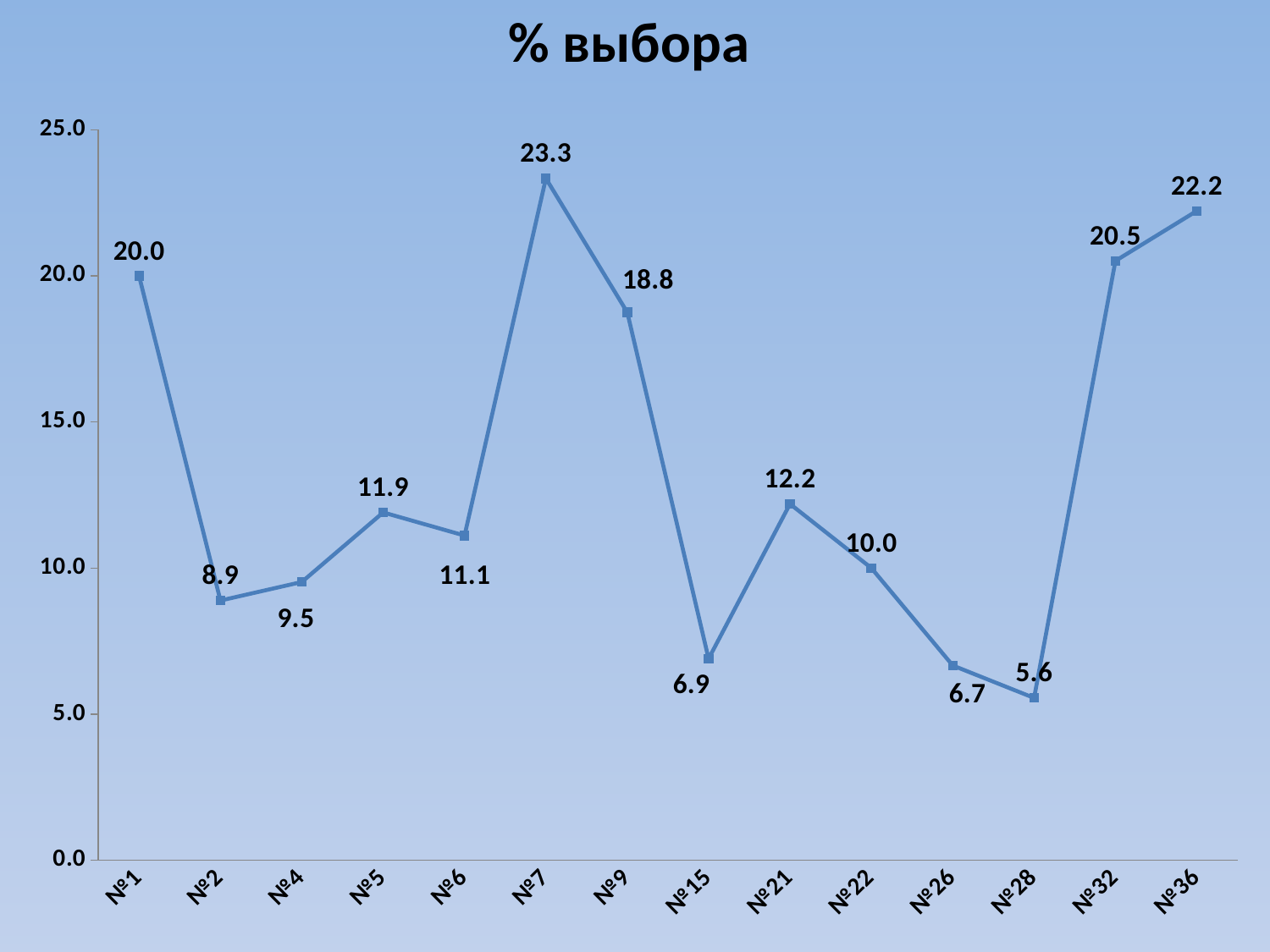
What is the difference between the values for №7 and №9? 4.5 What is the value for №15? 6.9 What kind of chart is shown? line chart What is the difference between the values for №36 and №1? 2.2 Which is larger, the value for №21 or the value for №22? №21 Which category has the lowest value? №28 What is the title of the chart? % выбора What is the value for №32? 20.5 How many categories are plotted on the x axis? 14 What is the value for №7? 23.3 Which category has the highest value? №7 Is the value for №26 greater or less than 10.0? less